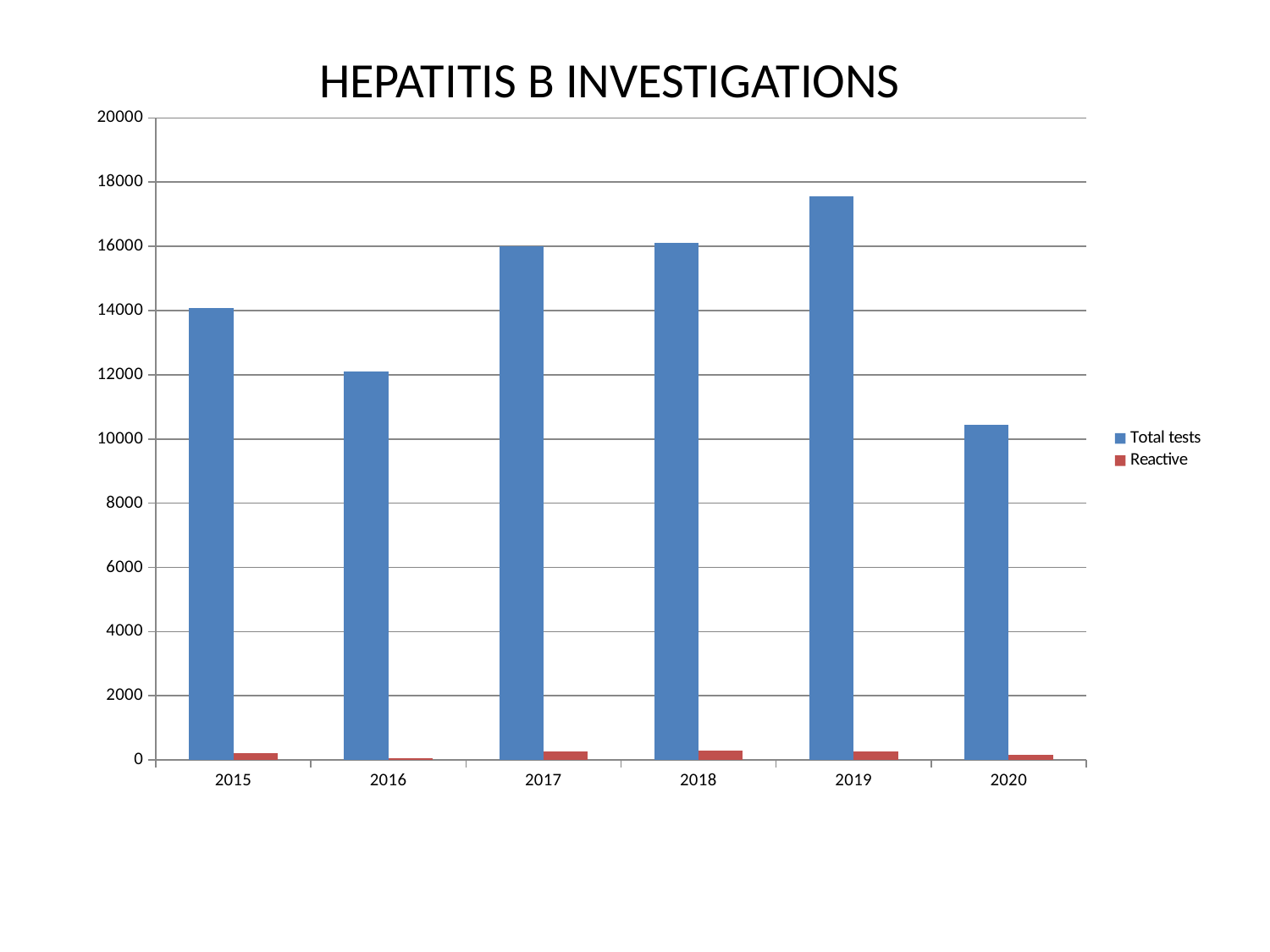
Which year has the lowest value for Total tests? 2020 Which series is shown in red in the legend? Reactive How many years are shown on the x axis? 6 Which is larger, Total tests in 2015 or Total tests in 2016? 2015 Is the value for Total tests in 2020 greater or less than 12000? less How many series does the legend list? 2 Is the value for Total tests in 2019 greater or less than 16000? greater What is the title of the chart? HEPATITIS B INVESTIGATIONS What kind of chart is shown on the slide? Bar chart Which year has the lowest value for Reactive? 2016 Which year has the highest value for Total tests? 2019 Is the value for Total tests in 2016 greater or less than 14000? less